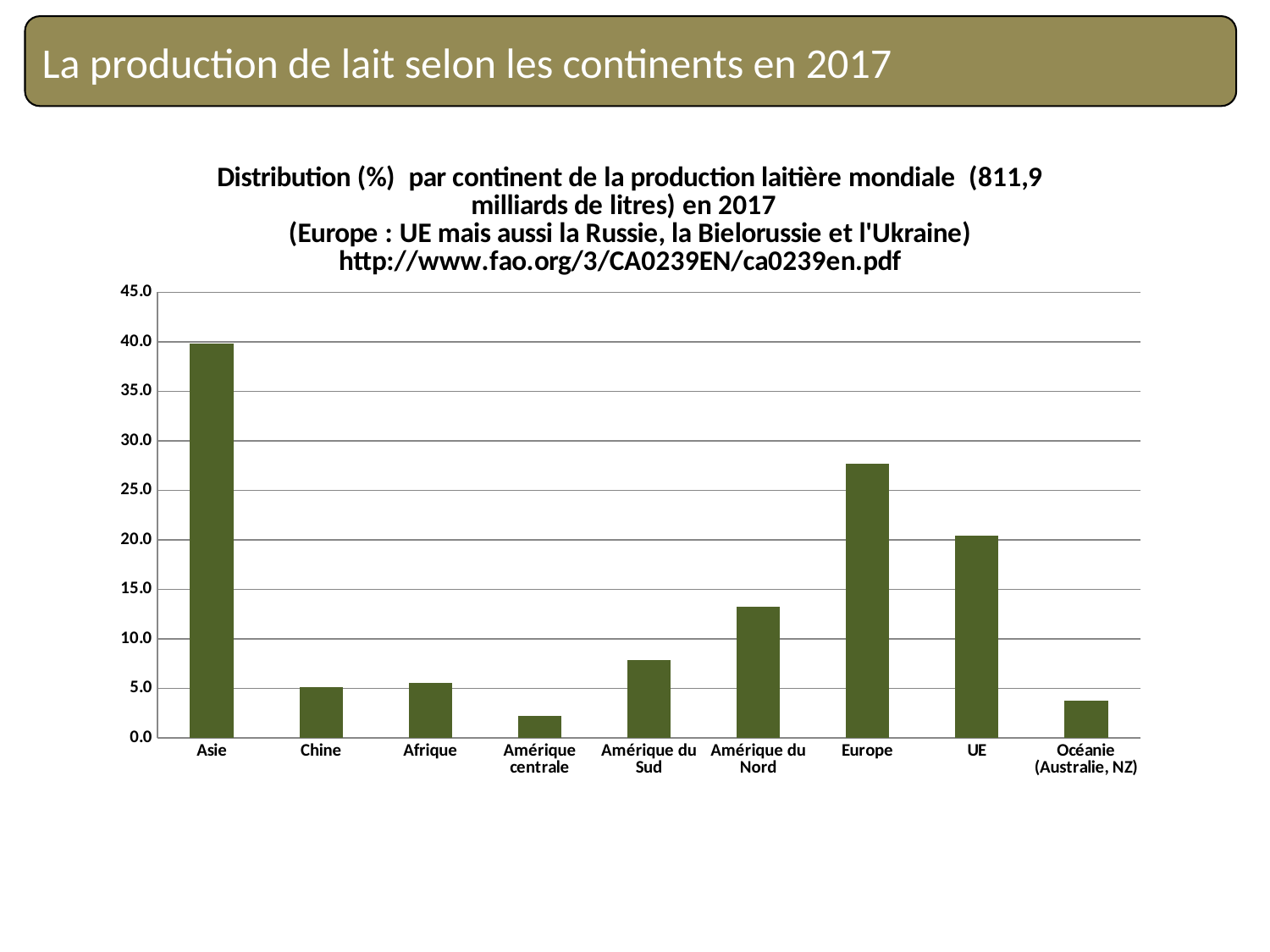
Is the value for UE greater or less than 25.0? less What is the total world milk production stated in the chart title? 811,9 milliards de litres Which category has the lowest value in the chart? Amérique centrale Is the value for Europe greater or less than 25.0? greater Is the value for Asie greater or less than 35.0? greater How many categories are shown on the x axis of the chart? 9 Which category has the highest value in the chart? Asie Which is larger, the value for Amérique du Nord or the value for Amérique du Sud? Amérique du Nord What kind of chart is shown on the slide? bar chart Which is larger, the value for Europe or the value for UE? Europe